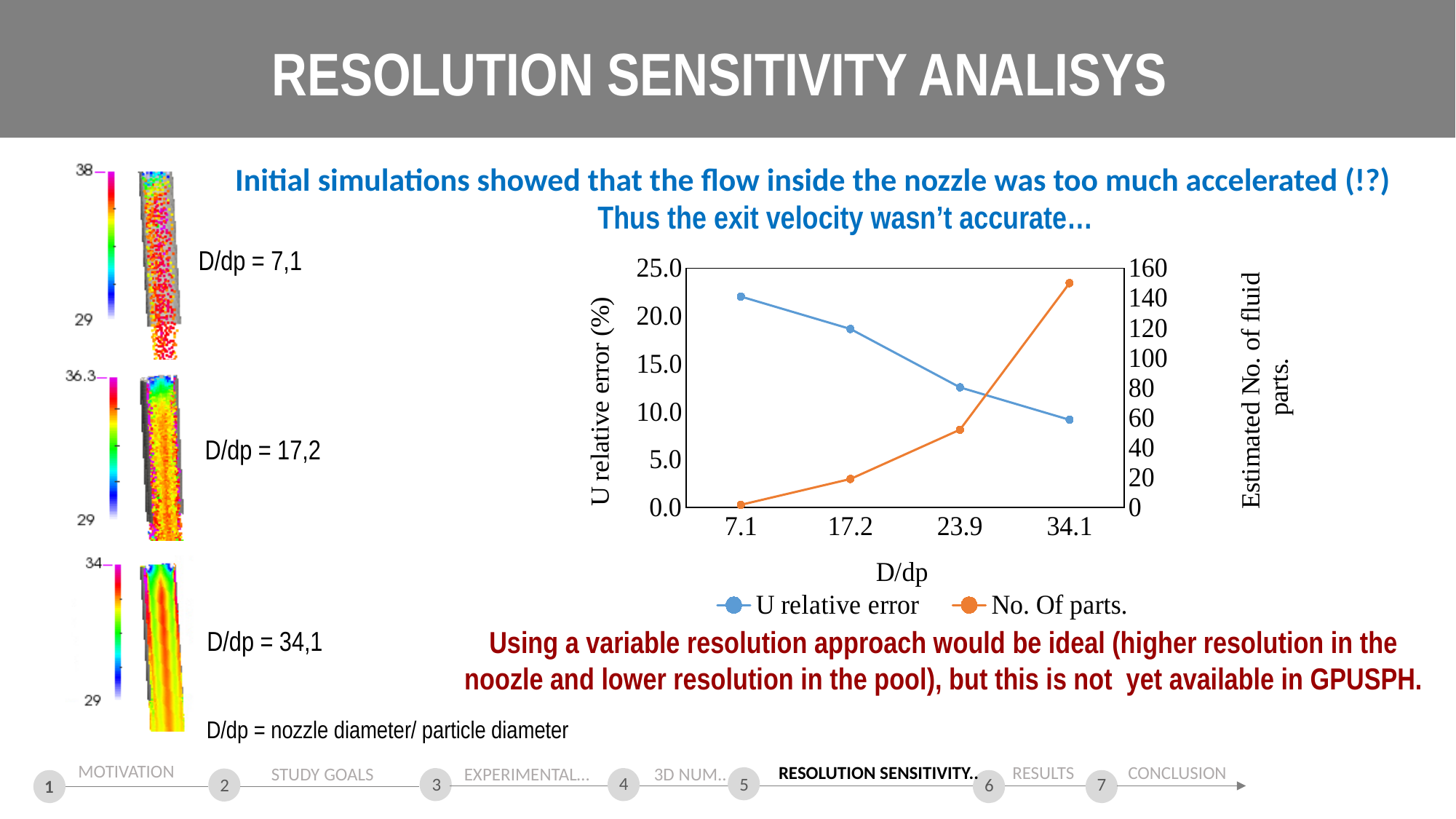
Does the No. Of parts. series rise or fall as D/dp increases along the x axis? rise At which D/dp value is the U relative error lowest? 34.1 At which D/dp value is the No. Of parts. series highest? 34.1 Is the U relative error at D/dp = 7.1 greater or less than 20.0? greater At which D/dp value is the U relative error highest? 7.1 Is the No. Of parts. value at D/dp = 34.1 greater or less than 140? greater How many series does the chart legend list? 2 How many D/dp values are plotted along the x axis of the chart? 4 Does the U relative error rise or fall as D/dp increases along the x axis? fall Is the No. Of parts. value at D/dp = 17.2 greater or less than 40? less What is the title of the x axis of the chart? D/dp What kind of chart is shown on the slide? line chart